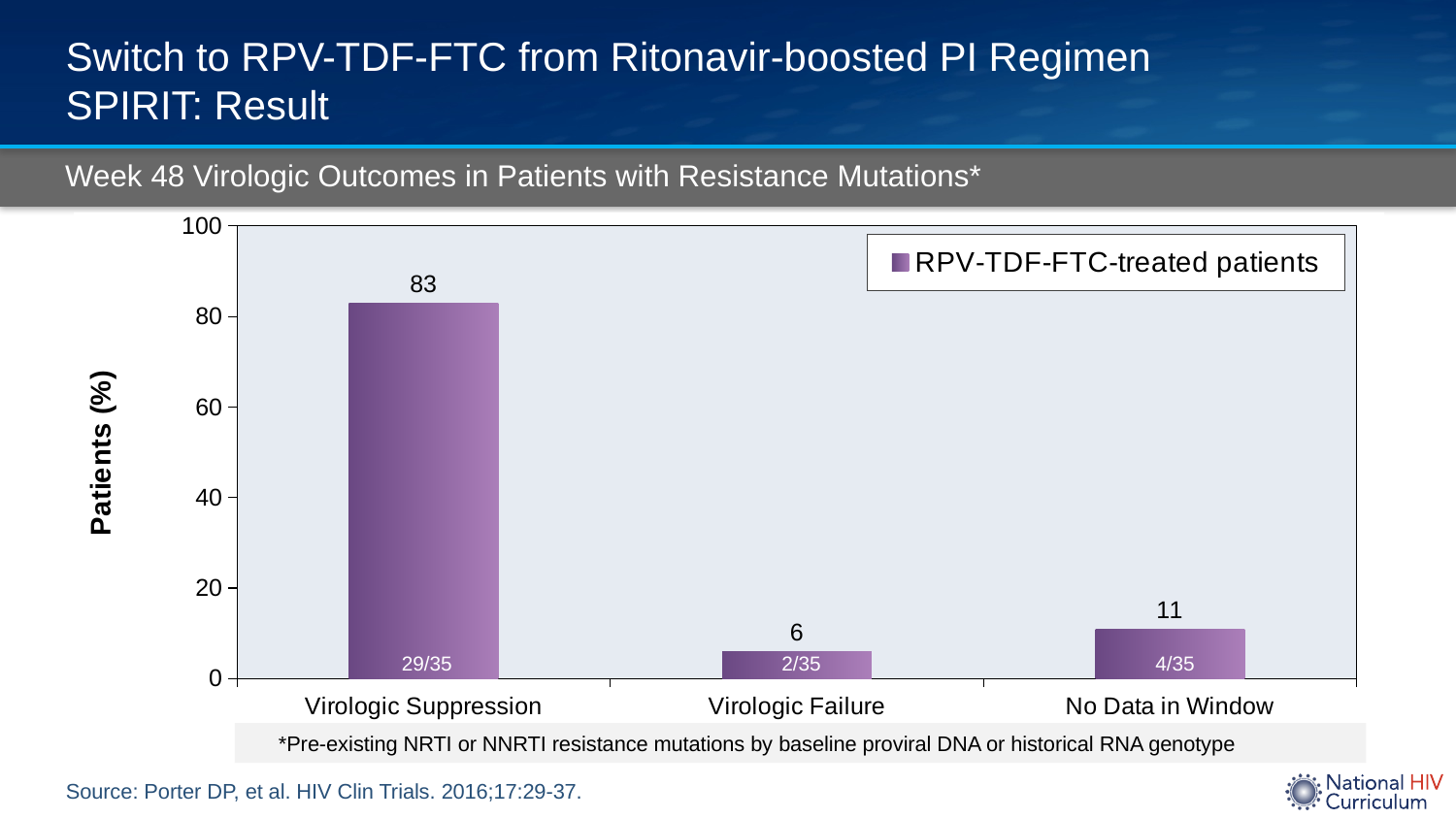
Is the value for Virologic Suppression greater or less than 80? greater Which category has the lowest value? Virologic Failure What fraction is printed inside the Virologic Suppression bar? 29/35 What kind of chart is shown? Bar chart What is the difference in percentage points between Virologic Suppression and No Data in Window? 72 Which category has the highest value? Virologic Suppression Which is larger, the value for Virologic Failure or the value for No Data in Window? No Data in Window What percentage of patients achieved Virologic Suppression? 83 What percentage of patients had No Data in Window? 11 What percentage of patients had Virologic Failure? 6 How many series does the legend list? 1 How many categories are shown on the x axis? 3